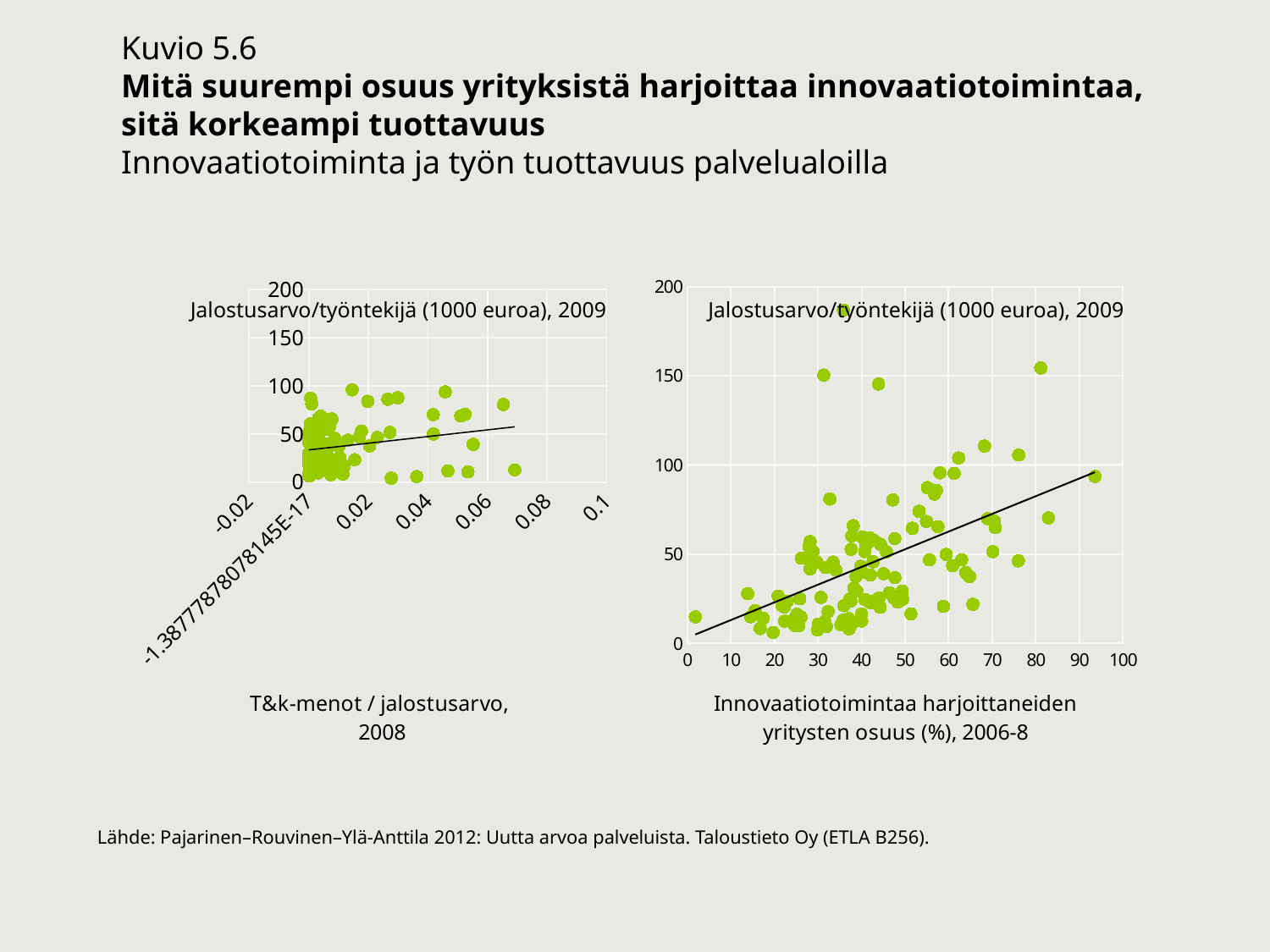
What is the x-axis label of the right chart? Innovaatiotoimintaa harjoittaneiden yritysten osuus (%), 2006-8 In the right chart, is the value of the highest plotted point greater or less than 150? greater In the right chart, does the fitted trend line rise or fall as the share of innovating firms increases along the x axis? Rise In the right chart, is the value of the lowest plotted point greater or less than 50? less In the left chart, does the fitted trend line rise or fall along the x axis? Rise What is the title shown on the y axis of the right chart? Jalostusarvo/työntekijä (1000 euroa), 2009 What kind of chart is the right chart (Innovaatiotoimintaa harjoittaneiden yritysten osuus (%), 2006-8)? Scatter chart What kind of chart is the left chart (T&k-menot / jalostusarvo, 2008)? Scatter chart